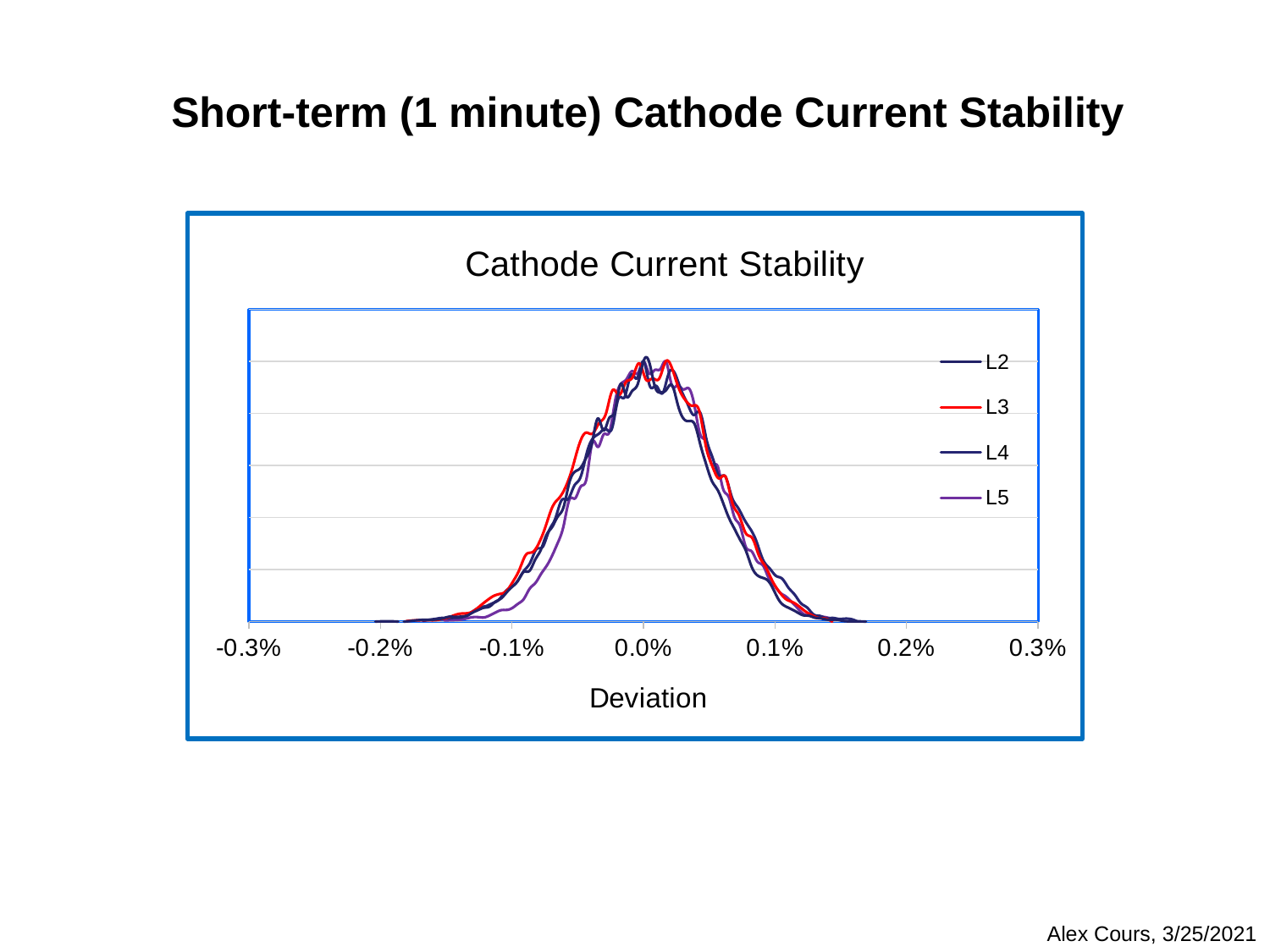
How many series does the legend of the chart list? 4 Which series is drawn in red in the chart? L3 What kind of chart is shown on the slide? line chart What is the highest value labelled on the x axis of the chart? 0.3% What is the title of the chart? Cathode Current Stability What is the lowest value labelled on the x axis of the chart? -0.3% Do the curves rise or fall along the x axis from -0.3% to 0.0%? rise Do the curves rise or fall along the x axis from 0.0% to 0.3%? fall How many tick labels are shown on the x axis of the chart? 7